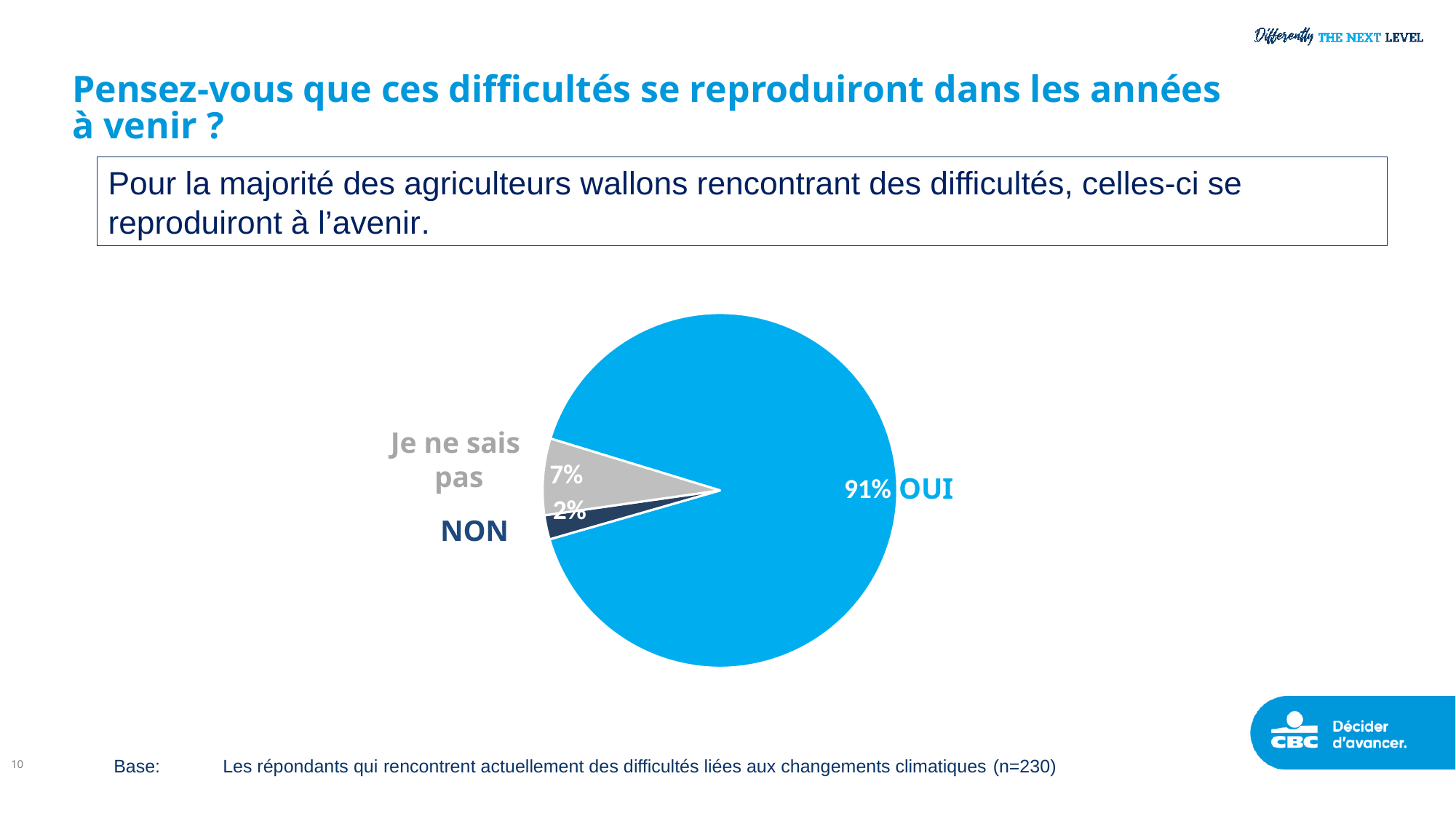
Which response has the smallest share of the pie? NON Which is larger, the share for NON or the share for 'Je ne sais pas'? Je ne sais pas What percentage of respondents answered OUI? 91% What kind of chart is shown on the slide? pie chart What is the base size (n) stated for the chart? n=230 How many slices does the pie chart have? 3 What percentage of respondents answered 'Je ne sais pas'? 7% What colour is the OUI slice of the pie? light blue What is the difference in percentage points between 'Je ne sais pas' and NON? 5 What percentage of respondents answered NON? 2% Which response has the largest share of the pie? OUI What is the difference in percentage points between OUI and 'Je ne sais pas'? 84